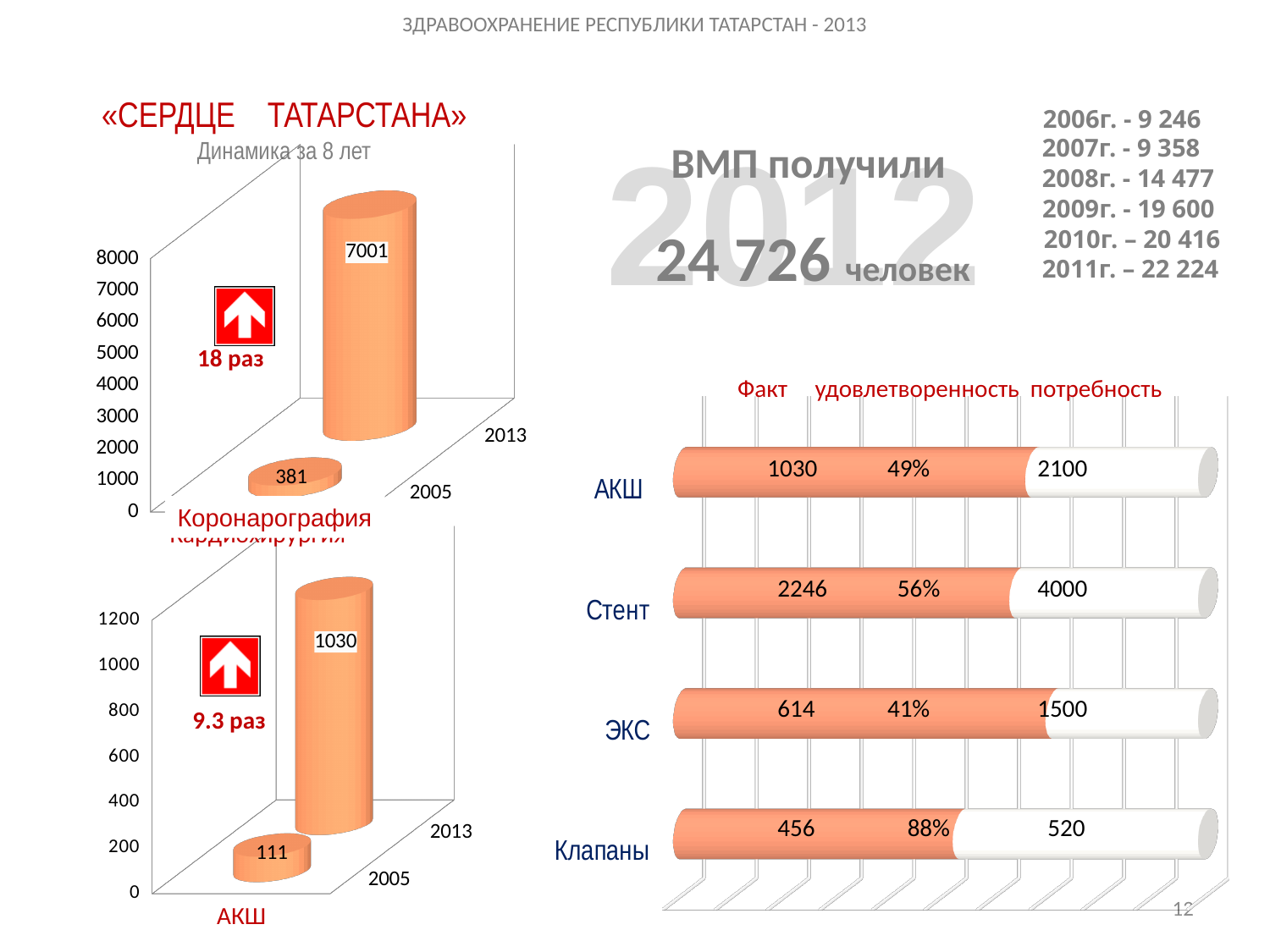
In the АКШ chart (bottom left), how many bars are plotted? 2 In the АКШ chart (bottom left), what is the value for 2013? 1030 In the right-hand chart, what is the Факт value for Стент? 2246 In the right-hand chart, what is the удовлетворенность percentage for Клапаны? 88% In the Коронарография chart (top left), what is the value for 2005? 381 In the АКШ chart (bottom left), which year has the higher value, 2005 or 2013? 2013 In the Коронарография chart (top left), what is the difference between the 2013 and 2005 values? 6620 In the Коронарография chart (top left), what is the value for 2013? 7001 In the right-hand chart, what is the потребность value for ЭКС? 1500 In the АКШ chart (bottom left), what is the value for 2005? 111 In the right-hand chart, which category has the highest потребность value? Стент What type of chart is the Коронарография chart (top left)? bar chart